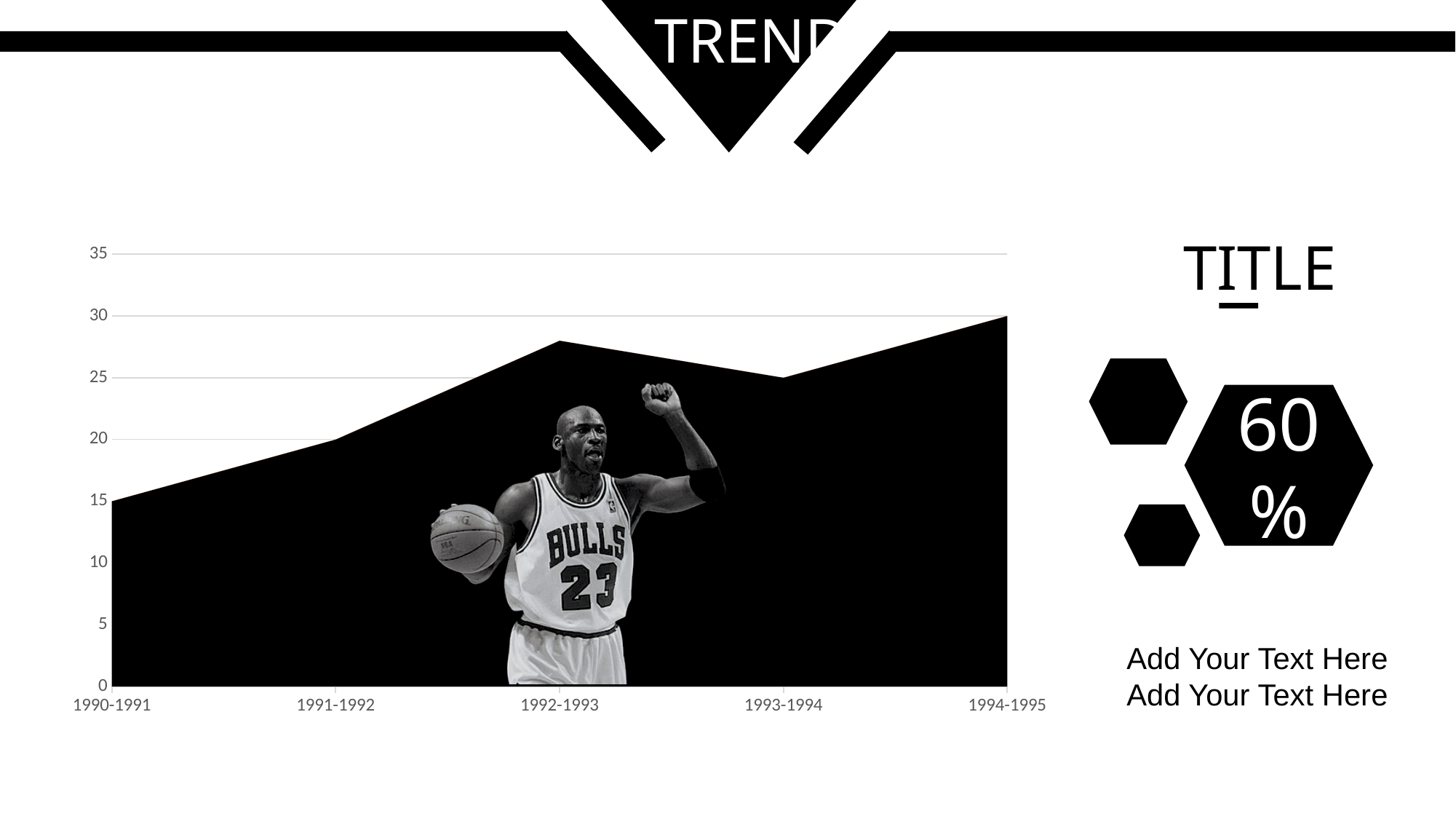
Is the value for 1993-1994 greater or less than 30? less What is the value for 1994-1995 in the chart? 30 Which season has the lowest value in the chart? 1990-1991 Is the value for 1992-1993 greater or less than 25? greater What is the value for 1990-1991 in the chart? 15 How many seasons are plotted along the x axis of the chart? 5 Which is larger, the value for 1992-1993 or the value for 1993-1994? 1992-1993 What kind of chart is shown on the slide? area chart Which season has the highest value in the chart? 1994-1995 What is the value for 1991-1992 in the chart? 20 Does the value generally rise or fall from 1990-1991 to 1994-1995? rise What is the difference between the values for 1994-1995 and 1990-1991? 15